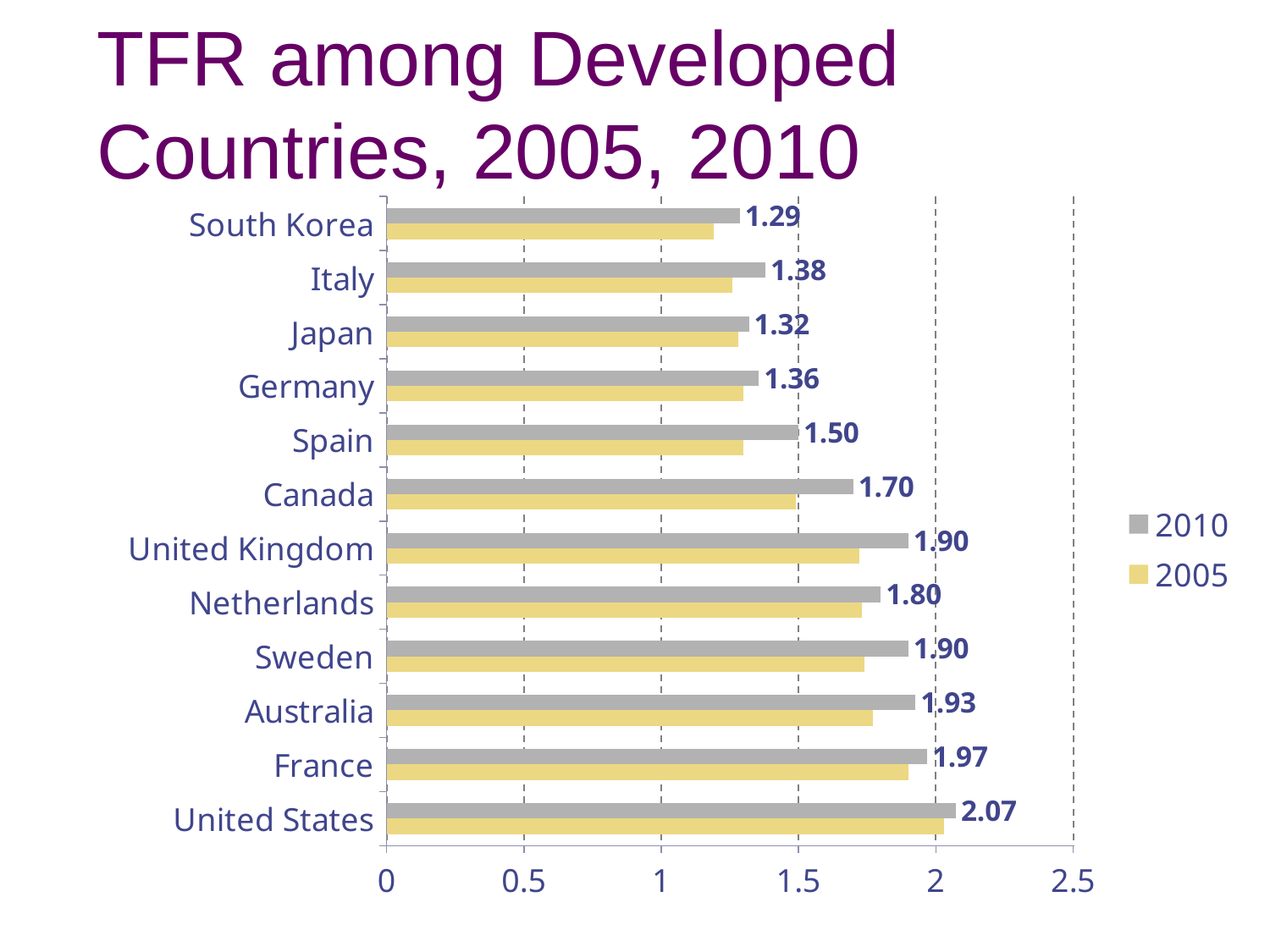
How many series does the legend list? 2 Which has the larger 2010 TFR value, France or Australia? France Which country has the highest 2010 TFR value? United States What is the 2010 TFR value for the United States? 2.07 Is the 2005 value for the United Kingdom greater or less than 1.5? greater Which country has the lowest 2010 TFR value? South Korea What is the difference between the 2010 TFR values for the United States and South Korea? 0.78 Is the 2005 value for Spain greater or less than 1.5? less Which colour represents the 2005 series in the legend? yellow How many countries are shown on the chart? 12 What is the 2010 TFR value for Spain? 1.50 What kind of chart is shown on the slide? bar chart